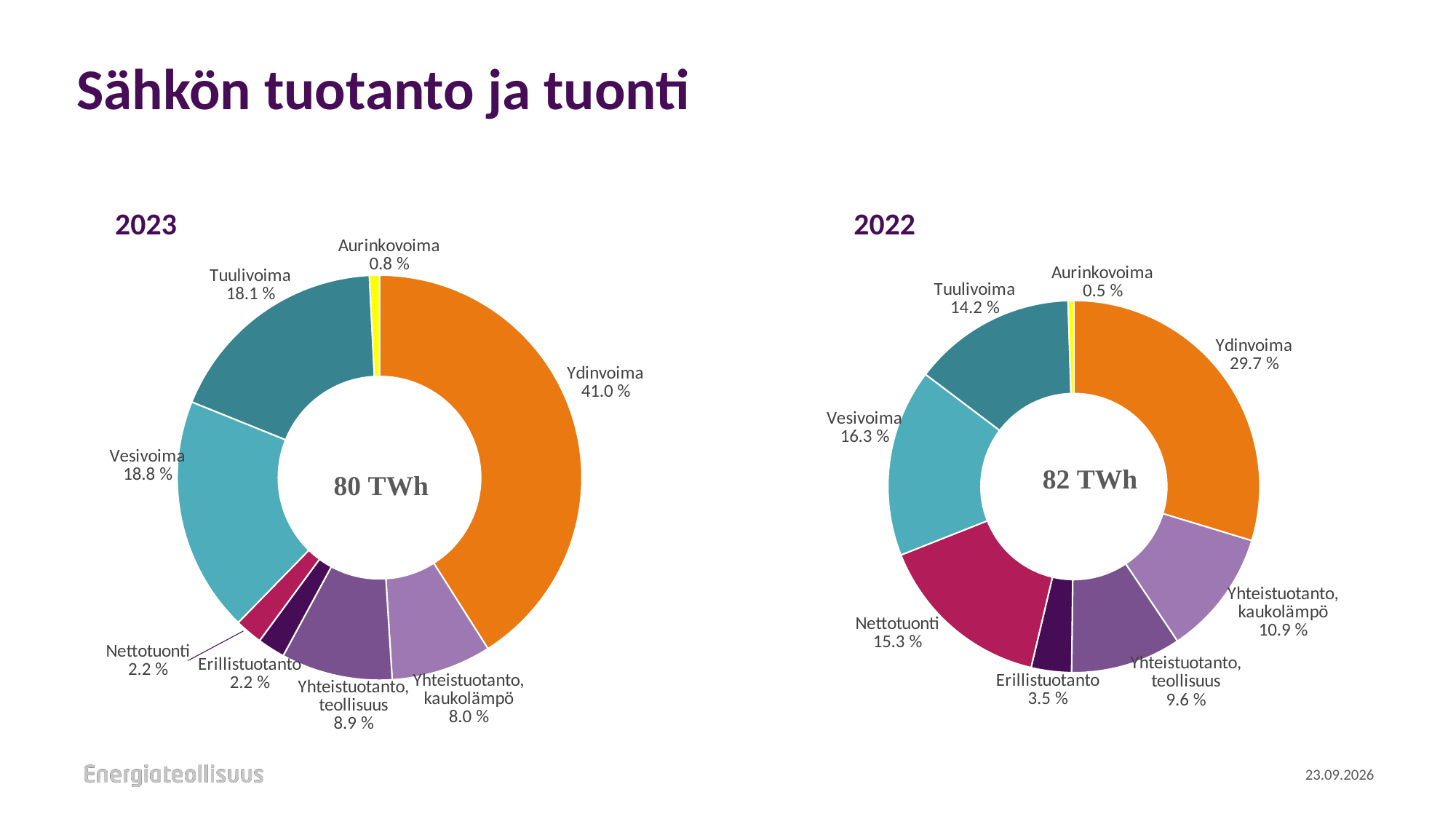
What total is printed in the centre of the 2023 chart? 80 TWh In the 2022 chart, what share does Nettotuonti have? 15.3 % In the 2023 chart, what share does Tuulivoima have? 18.1 % In the 2023 chart, what share does Ydinvoima have? 41.0 % In the 2023 chart, which category has the largest share? Ydinvoima In the 2022 chart, what share does Yhteistuotanto, kaukolämpö have? 10.9 % What total is printed in the centre of the 2022 chart? 82 TWh What kind of chart is the 2022 chart? Pie (donut) chart In the 2022 chart, which category has the smallest share? Aurinkovoima How many categories does the 2023 chart show? 8 In the 2022 chart, which is larger: Vesivoima or Tuulivoima? Vesivoima How many percentage points higher is the Ydinvoima share in the 2023 chart than in the 2022 chart? 11.3